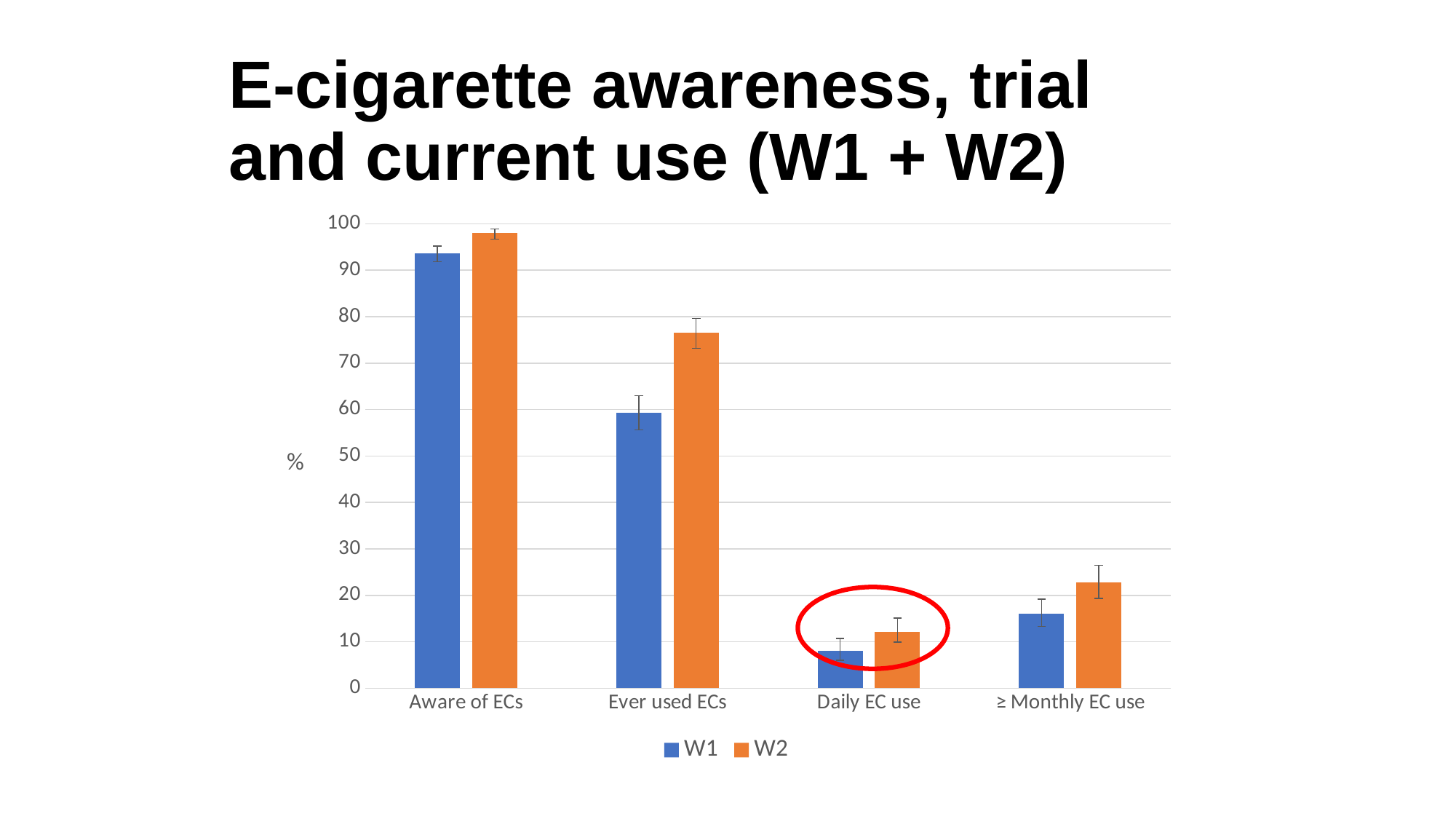
Is the W1 value for Aware of ECs greater or less than 90? greater Which is larger for Ever used ECs, the W1 value or the W2 value? W2 Is the W2 value for Daily EC use greater or less than 20? less Which category is circled in red on the chart? Daily EC use Which is larger, the W1 value for ≥ Monthly EC use or the W1 value for Daily EC use? ≥ Monthly EC use What kind of chart is shown on the slide? bar chart Which category has the highest W2 value? Aware of ECs What is the title of the chart on the slide? E-cigarette awareness, trial and current use (W1 + W2) How many categories are shown on the x axis? 4 How many series does the legend list? 2 Is the W1 value for Ever used ECs greater or less than 50? greater Which category has the lowest W1 value? Daily EC use